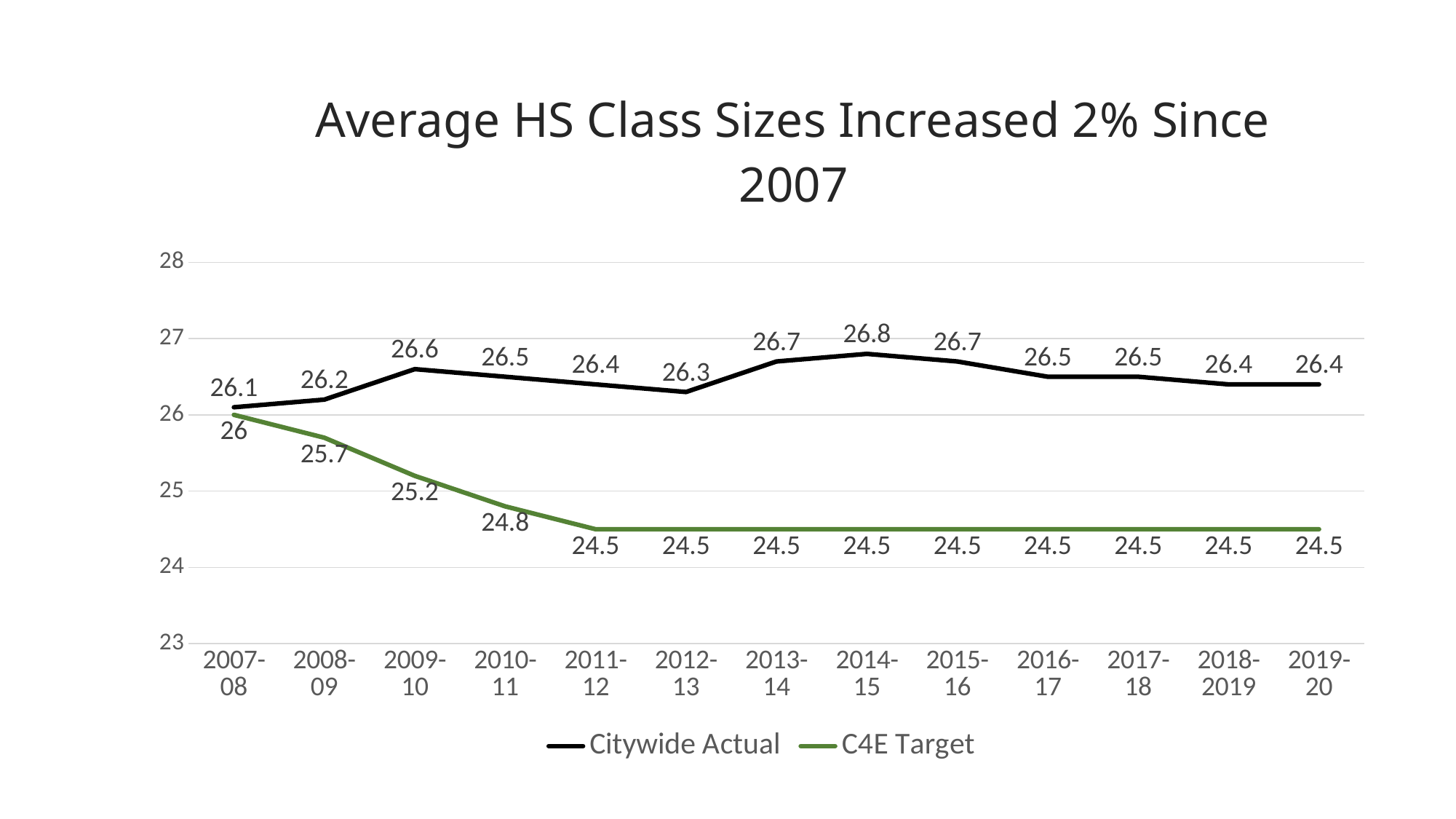
What kind of chart is shown? Line chart What is the Citywide Actual value for 2007-08? 26.1 What is the difference between Citywide Actual and C4E Target in 2019-20? 1.9 In which year is the Citywide Actual value lowest? 2007-08 What is the C4E Target value for 2008-09? 25.7 What is the title of the chart? Average HS Class Sizes Increased 2% Since 2007 Does the C4E Target line rise or fall from 2007-08 to 2011-12? Fall How many series does the legend list? 2 How many years are shown on the x axis? 13 In which year is the Citywide Actual value highest? 2014-15 What is the Citywide Actual value for 2014-15? 26.8 Which is larger in 2009-10, Citywide Actual or C4E Target? Citywide Actual